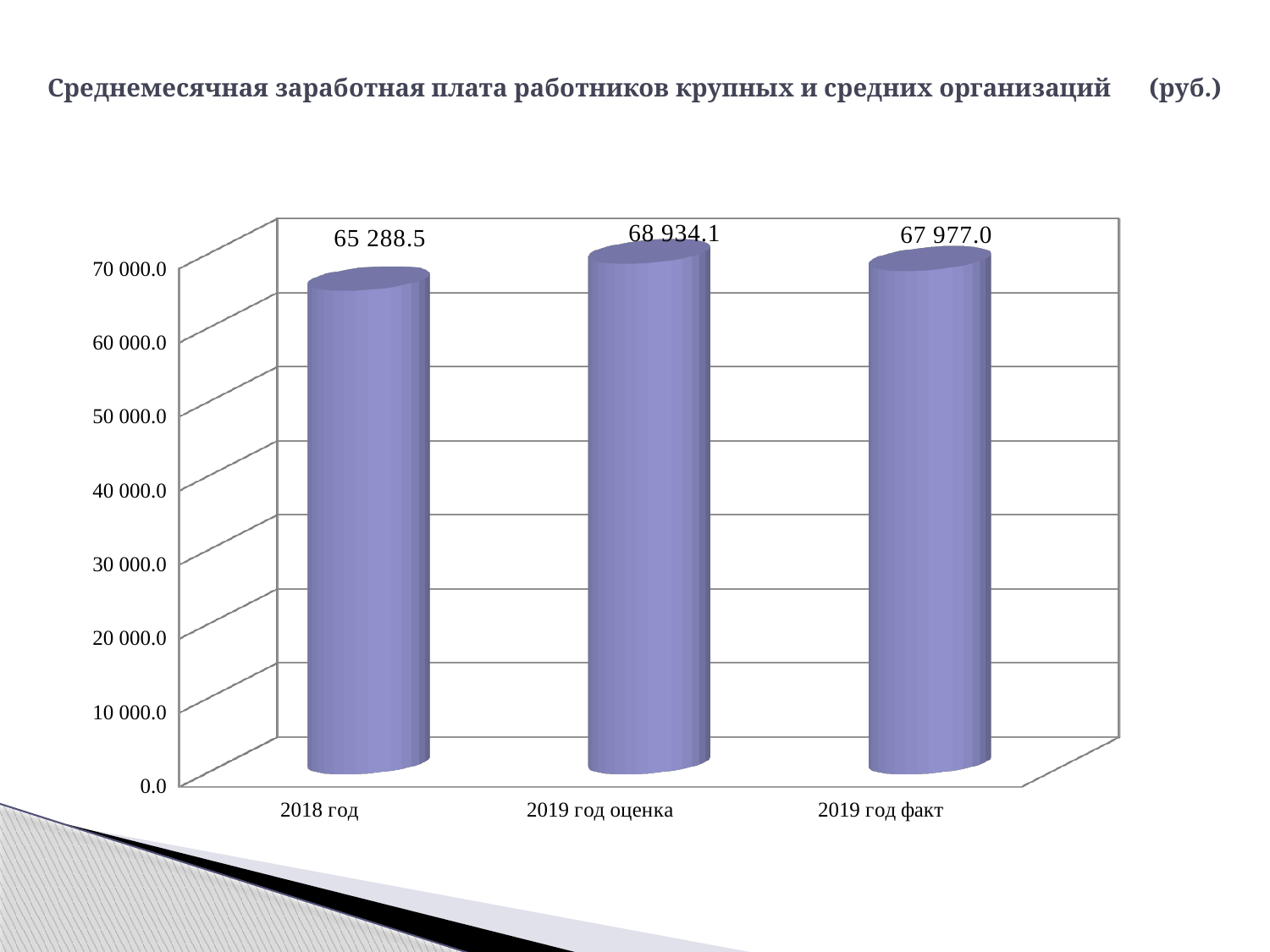
How many categories are shown on the x axis? 3 Which is larger, the value for 2019 год факт or the value for 2018 год? 2019 год факт What is the value for 2019 год оценка? 68 934.1 What is the value for 2019 год факт? 67 977.0 What is the value for 2018 год? 65 288.5 What unit is given in parentheses in the chart title? руб. What kind of chart is shown on the slide? bar chart Which category has the lowest value? 2018 год Is the value for 2018 год greater or less than 60 000.0? greater What is the difference between the values for 2019 год оценка and 2019 год факт? 957.1 Which category has the highest value? 2019 год оценка What is the difference between the values for 2019 год оценка and 2018 год? 3 645.6